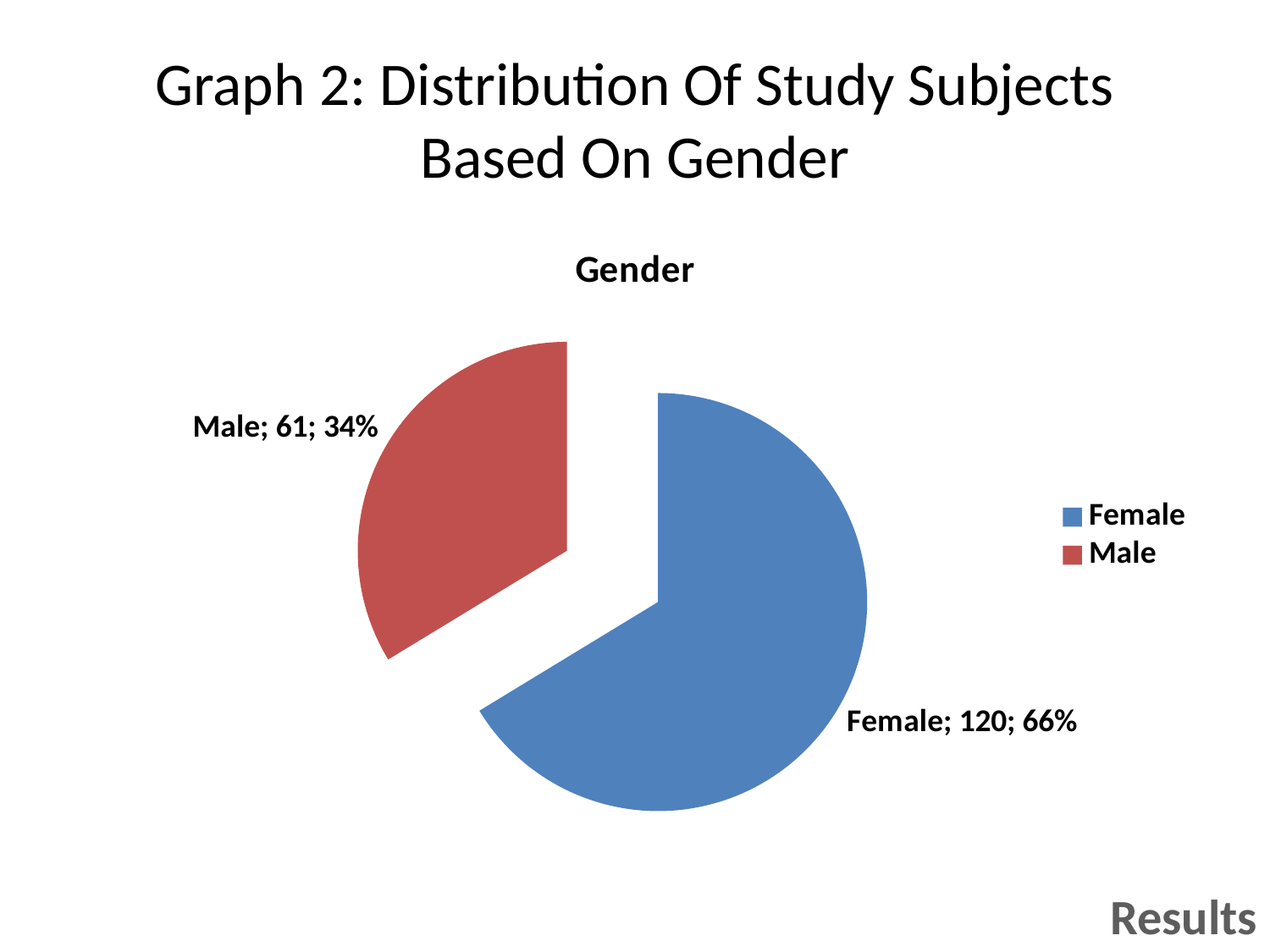
What kind of chart is shown on the slide? pie chart What share of the pie is the Female slice? 66% How many slices does the pie chart have? 2 How many subjects are Female? 120 What share of the pie is the Male slice? 34% Which is larger, the Female count or the Male count? Female Which gender has the smallest slice? Male Which gender has the largest slice? Female How many subjects are Male? 61 How many more Female subjects are there than Male subjects? 59 What colour is the Male slice? red What is the chart's title? Gender